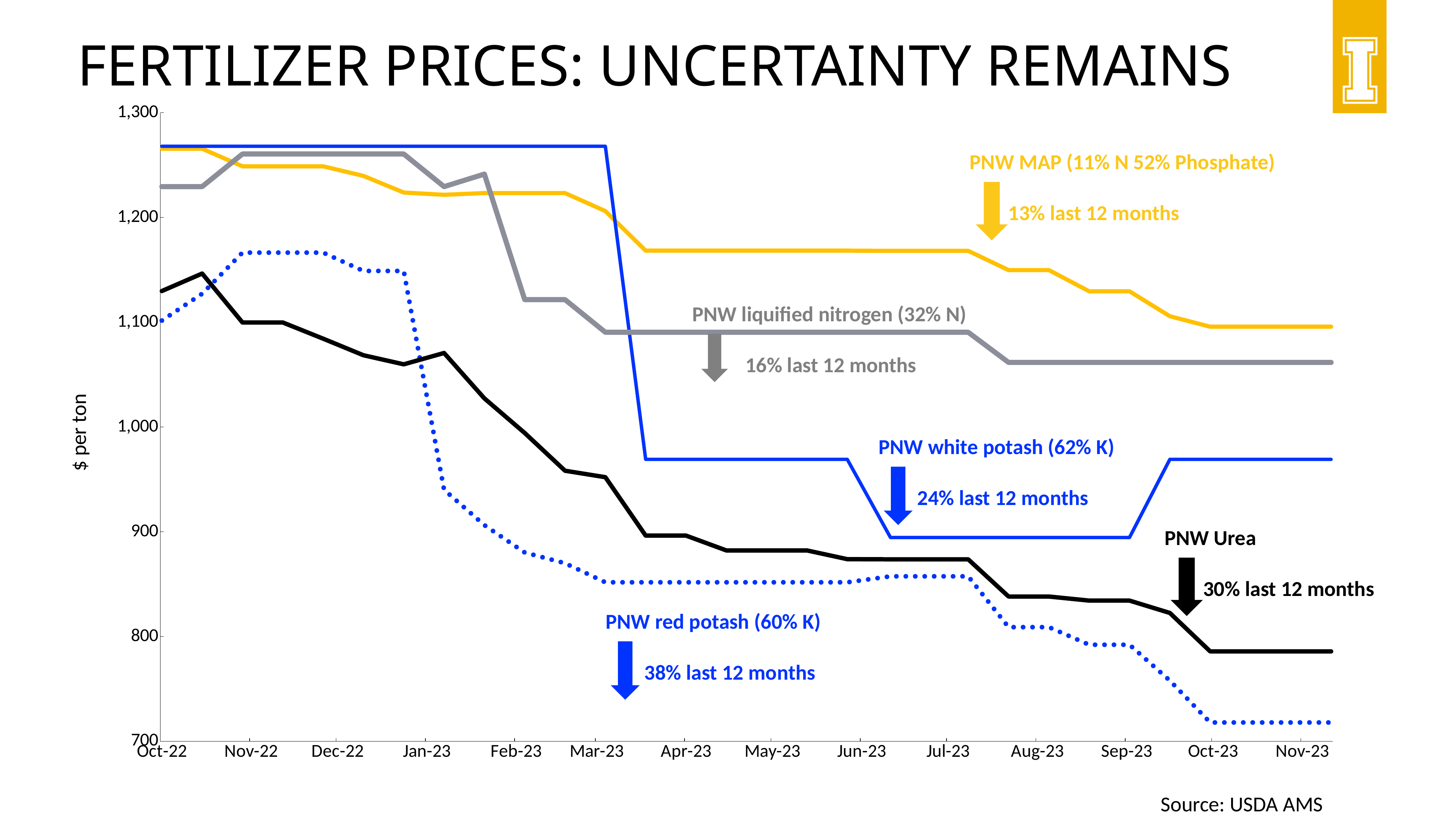
Is the value for PNW Urea at Nov-23 greater or less than 800? less According to the annotation, by what percentage did PNW red potash (60% K) fall over the last 12 months? 38% Is the value for PNW white potash (62% K) at Nov-23 greater or less than 1,000? less Which series has the highest price at Nov-23? PNW MAP (11% N 52% Phosphate) At Oct-22, which is higher: PNW white potash (62% K) or PNW red potash (60% K)? PNW white potash (62% K) Does the PNW Urea price rise or fall from Oct-22 to Nov-23? fall Which series has the lowest price at Nov-23? PNW red potash (60% K) What is the label on the vertical axis of the chart? $ per ton Is the value for PNW MAP (11% N 52% Phosphate) at Nov-23 greater or less than 1,000? greater What kind of chart is shown on the slide? line chart How many fertilizer price series are plotted on the chart? 5